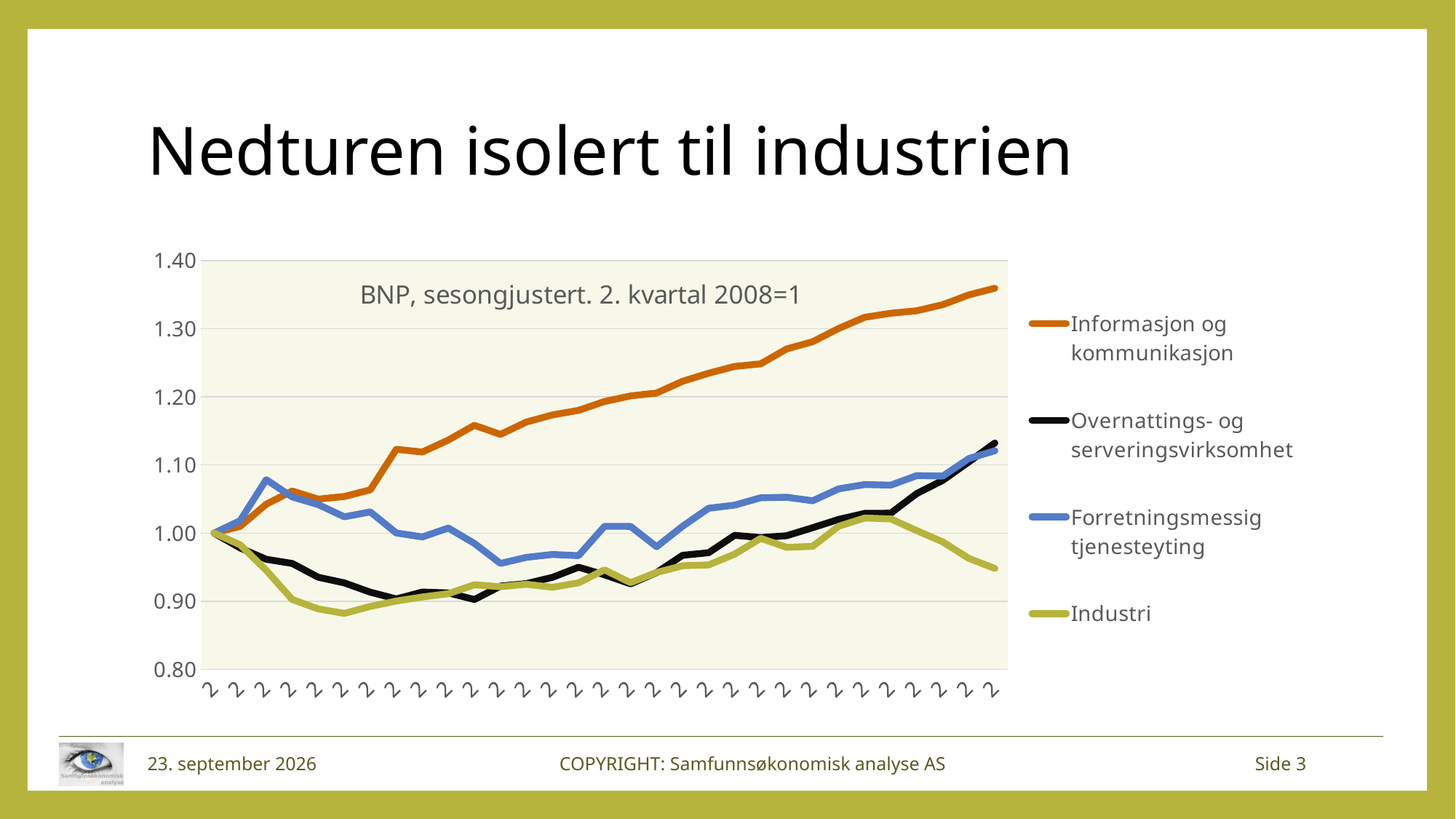
Which series has the lowest value at the right end of the chart? Industri Does the Informasjon og kommunikasjon line generally rise or fall along the x axis? rise What kind of chart is shown on the slide? line chart How many series does the legend list? 4 Is the final value of the Informasjon og kommunikasjon line greater or less than 1.30? greater Is the lowest value of the Industri line greater or less than 0.90? less What colour is the Informasjon og kommunikasjon line? orange At the right end of the chart, which is larger: Informasjon og kommunikasjon or Industri? Informasjon og kommunikasjon What is the title printed inside the chart area? BNP, sesongjustert. 2. kvartal 2008=1 Is the final value of the Forretningsmessig tjenesteyting line greater or less than 1.10? greater Which series has the highest value at the right end of the chart? Informasjon og kommunikasjon